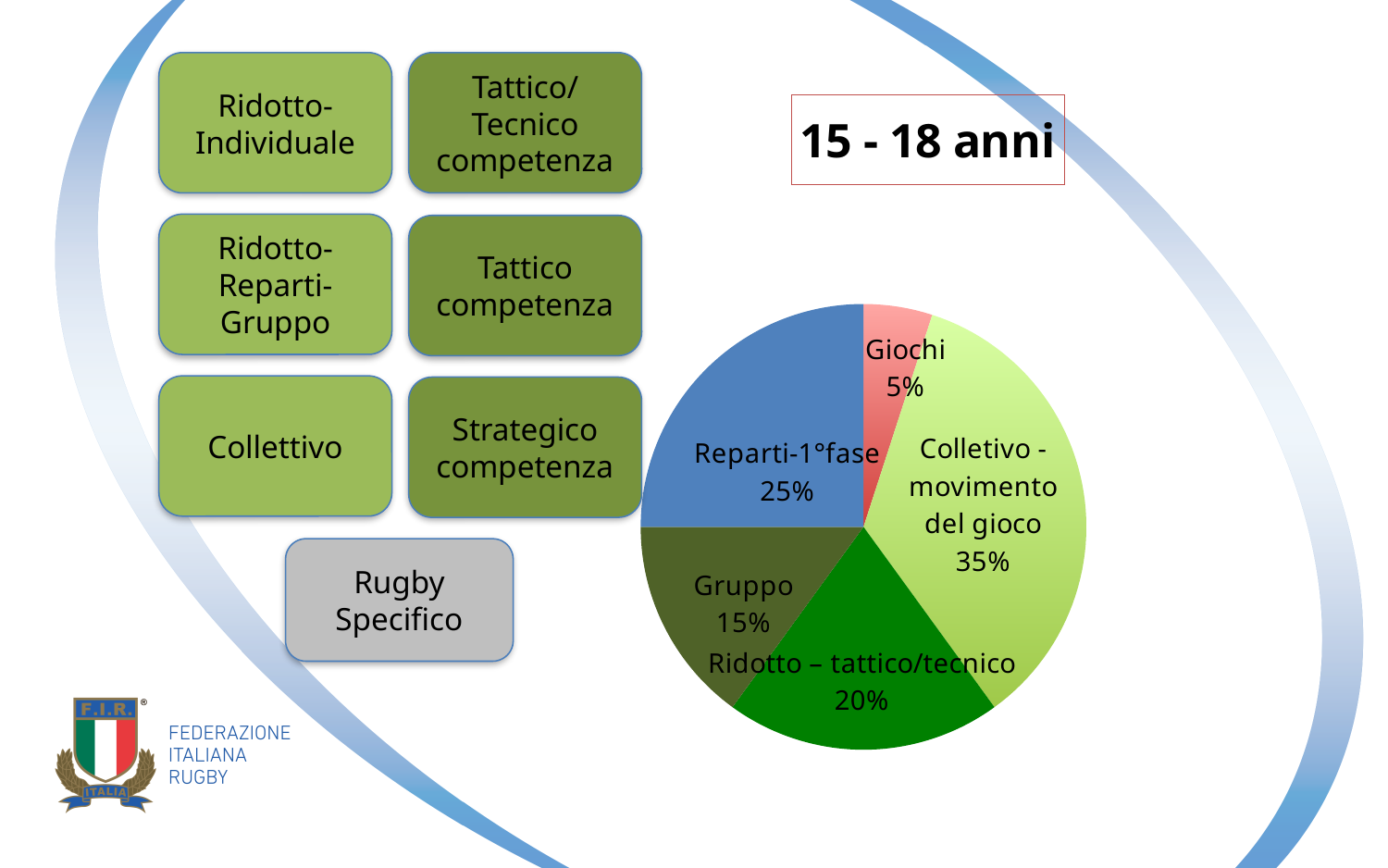
What age range is shown in the box above the pie chart? 15 - 18 anni What percentage does the Reparti-1°fase slice represent? 25% What percentage does the Gruppo slice represent? 15% How many slices does the pie chart have? 5 What percentage does the Colletivo - movimento del gioco slice represent? 35% Which slice of the pie is the smallest? Giochi Which slice of the pie is the largest? Colletivo - movimento del gioco What kind of chart is shown on the slide? pie chart What percentage does the Ridotto – tattico/tecnico slice represent? 20% Which is larger, the Ridotto – tattico/tecnico slice or the Reparti-1°fase slice? Reparti-1°fase What is the difference in percentage points between the Reparti-1°fase slice and the Gruppo slice? 10 What percentage does the Giochi slice represent? 5%